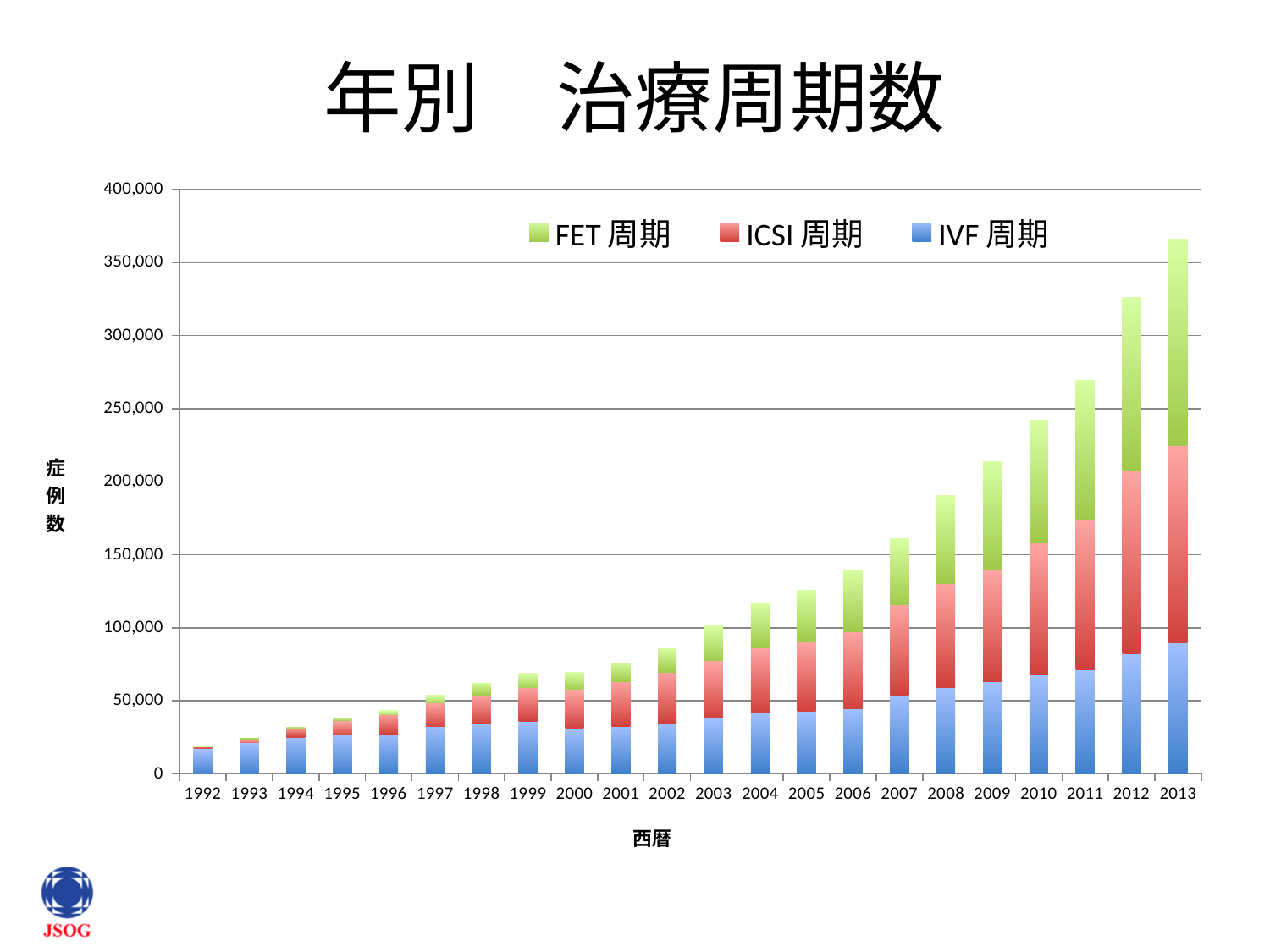
Which year has the highest total number of treatment cycles? 2013 Which series is shown in green in the legend? FET 周期 Is the total value for 2013 greater or less than 350,000? greater Is the total value for 1992 greater or less than 50,000? less Which year has the lowest total number of treatment cycles? 1992 Do the total treatment cycles rise or fall from 1992 to 2013? Rise How many series does the legend list? 3 Is the total value for 2010 greater or less than 250,000? less How many years are shown along the x axis? 22 Which year has the larger total, 2012 or 2013? 2013 What is the title of the chart? 年別 治療周期数 What kind of chart is shown on the slide? Stacked bar chart